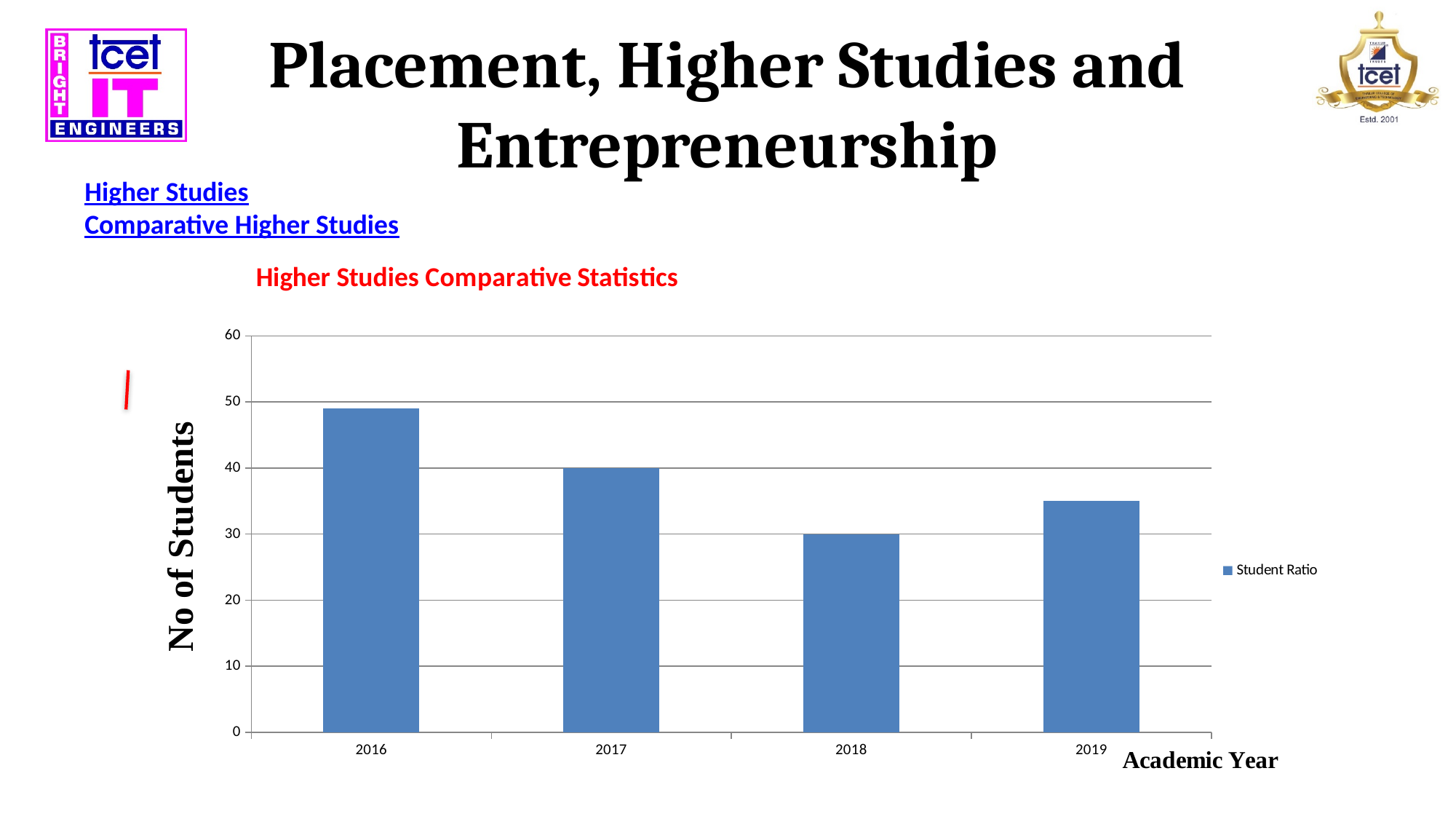
Which academic year has the lowest number of students? 2018 Is the value for 2019 greater or less than 40? less Is the value for 2016 greater or less than 40? greater What is the name of the series shown in the chart legend? Student Ratio What is the number of students for 2017? 40 How many series does the chart legend list? 1 What is the title of the chart? Higher Studies Comparative Statistics Which academic year has the highest number of students? 2016 What is the number of students for 2018? 30 What is the difference between the number of students in 2017 and 2018? 10 How many academic years are shown on the x axis of the chart? 4 What type of chart is shown on the slide? bar chart